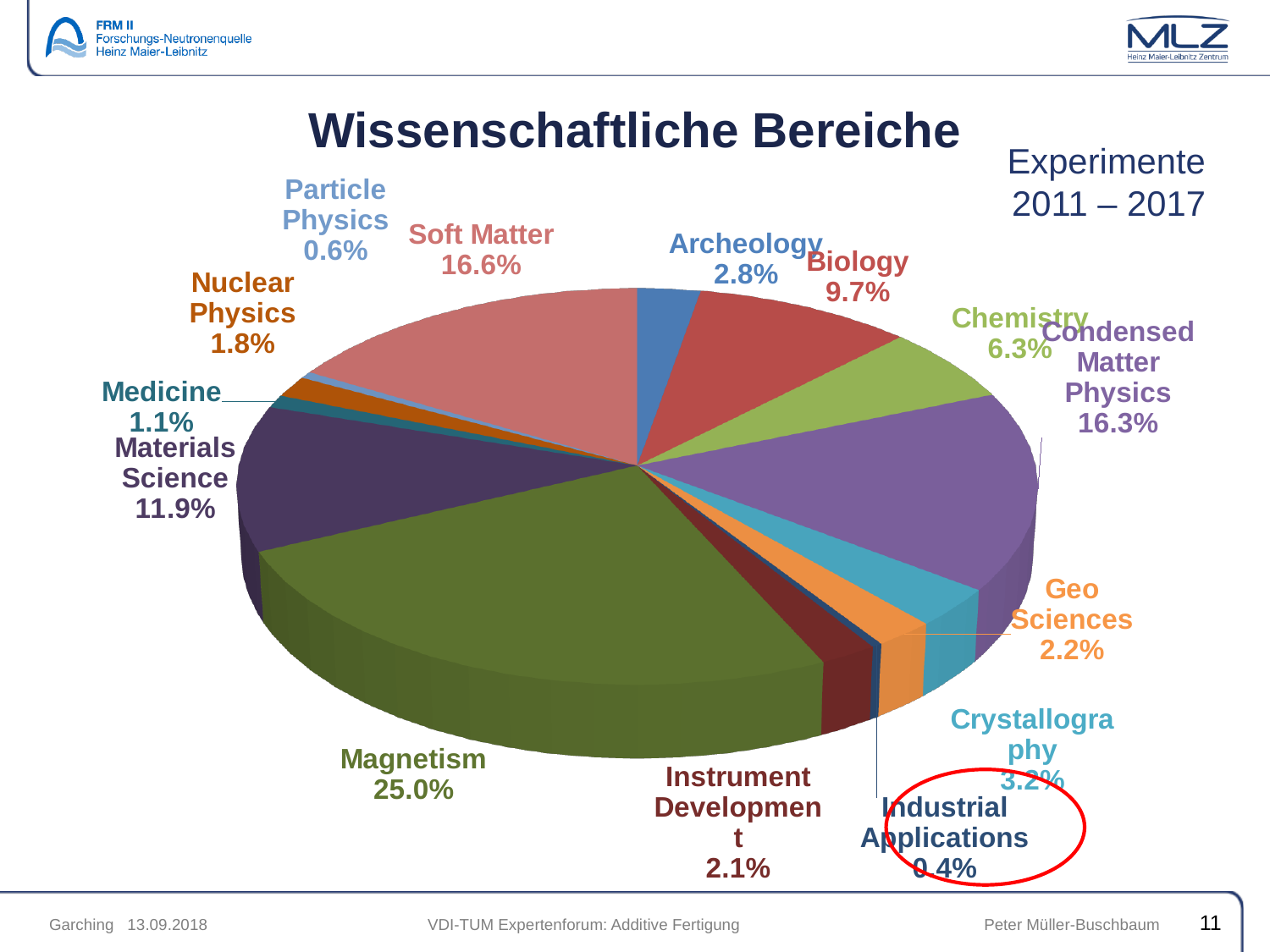
Which has a larger share, Biology or Chemistry? Biology How many categories are shown in the pie chart? 14 What is the value shown for Soft Matter? 16.6% What is the difference between the shares of Soft Matter and Condensed Matter Physics? 0.3% What share of the pie does Magnetism have? 25.0% What is the value shown for Condensed Matter Physics? 16.3% What is the value shown for Materials Science? 11.9% Which category is highlighted with a red circle on the slide? Industrial Applications Which category has the largest share of the pie? Magnetism Which category has the smallest share of the pie? Industrial Applications What is the title of the chart? Wissenschaftliche Bereiche What kind of chart is shown on the slide? pie chart